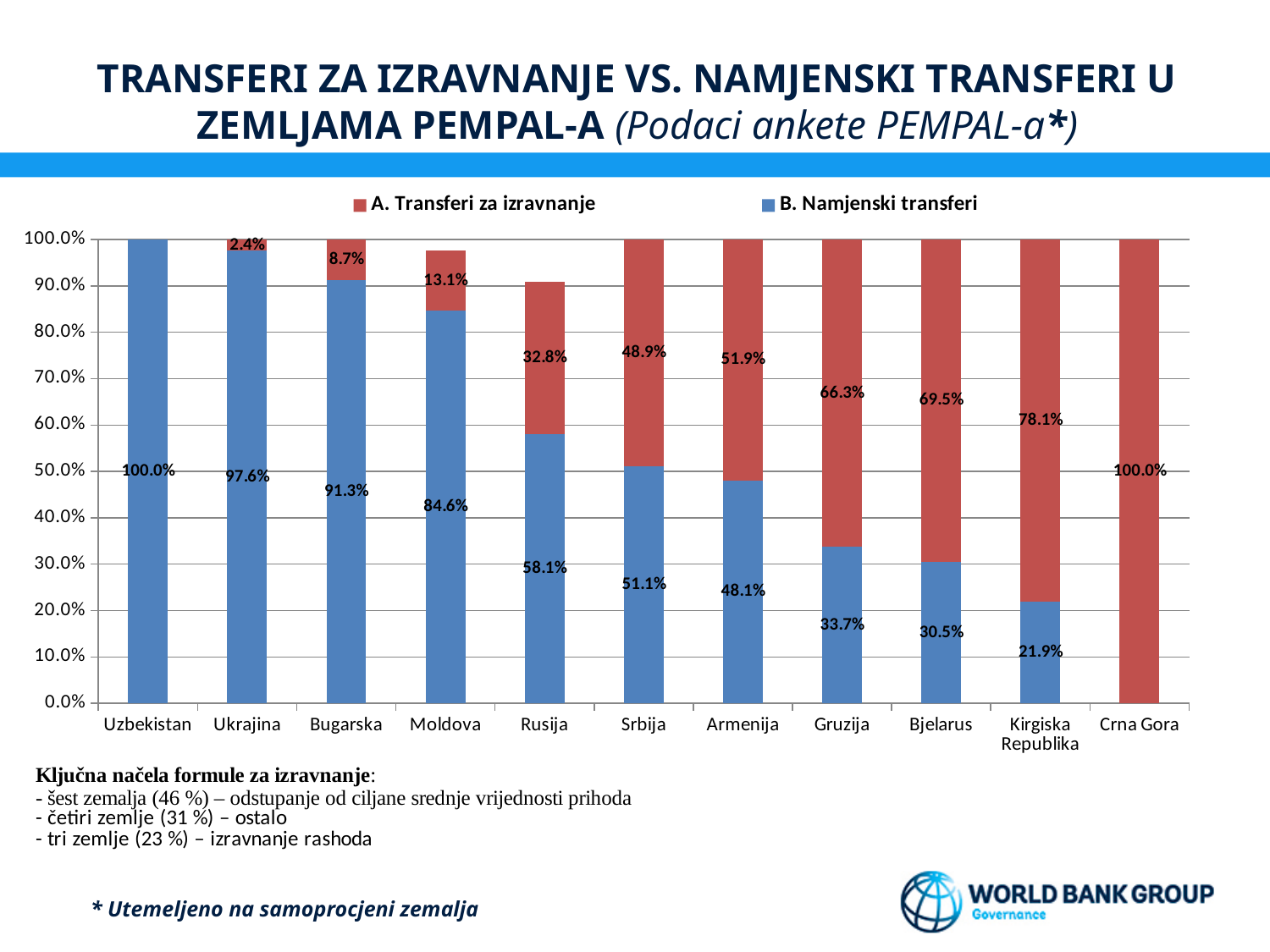
Which is larger for Armenija: A. Transferi za izravnanje or B. Namjenski transferi? A. Transferi za izravnanje What is the value of A. Transferi za izravnanje for Ukrajina? 2.4% How many series does the legend list? 2 Which country has the highest value for A. Transferi za izravnanje? Crna Gora What is the value of A. Transferi za izravnanje for Gruzija? 66.3% What kind of chart is shown on the slide? stacked bar chart Among countries with a labelled B. Namjenski transferi value, which has the lowest? Kirgiska Republika What is the total of the stacked bar for Rusija? 90.9% What is the difference between the B. Namjenski transferi values for Rusija and Srbija? 7.0% Which colour represents B. Namjenski transferi in the chart? blue What is the value of B. Namjenski transferi for Moldova? 84.6% How many countries are shown on the x axis? 11